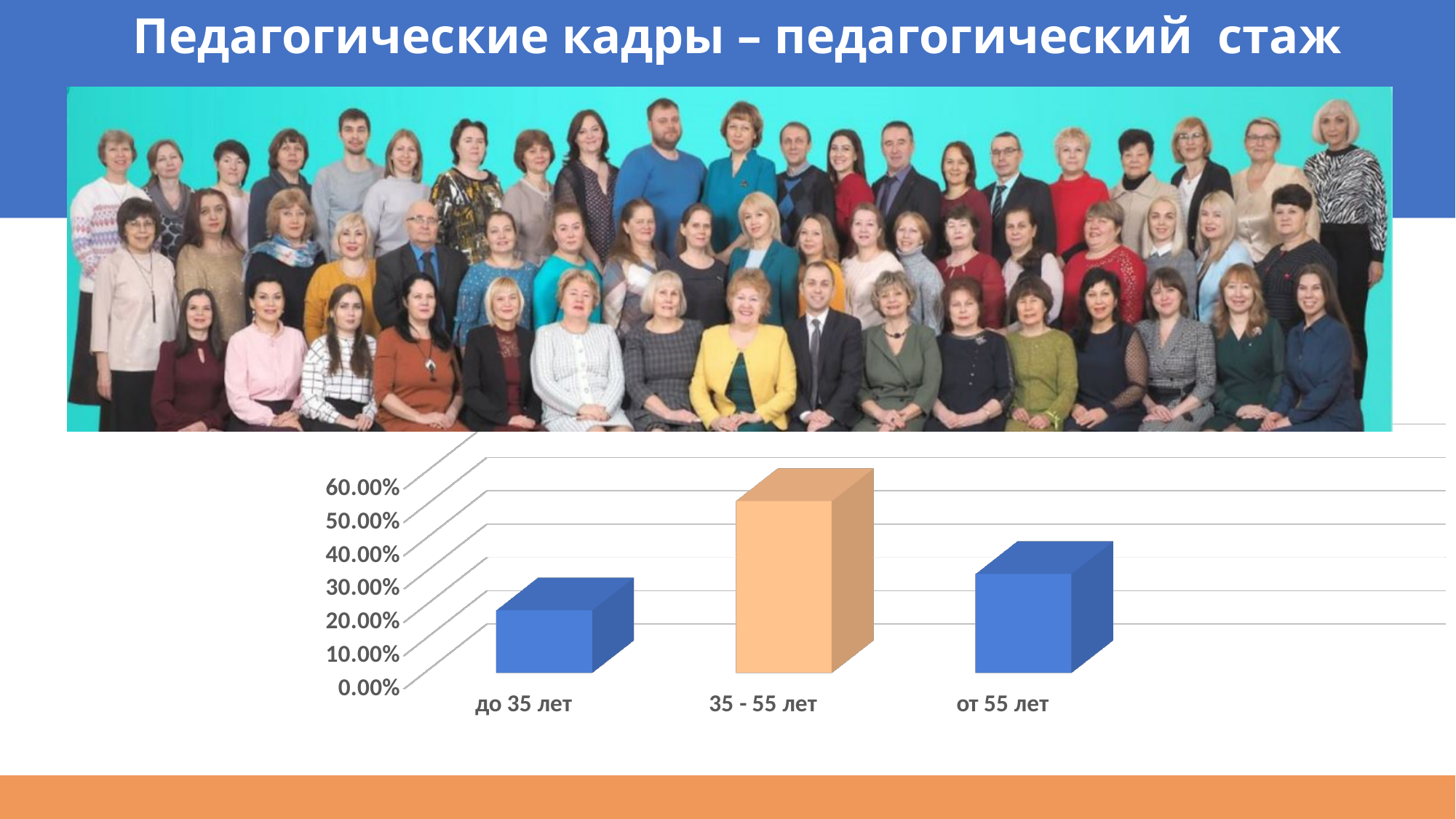
How many categories are shown on the x axis of the chart? 3 Which category has the highest bar in the chart? 35 - 55 лет Do the values rise or fall from 35 - 55 лет to от 55 лет? fall Which category has the lowest bar in the chart? до 35 лет Is the value for от 55 лет greater or less than 10.00%? greater Is the value for 35 - 55 лет greater or less than 40.00%? greater Is the value for до 35 лет greater or less than 30.00%? less What kind of chart is shown on the slide? bar chart Which is larger: the value for 35 - 55 лет or the value for от 55 лет? 35 - 55 лет What colour is the bar for 35 - 55 лет? orange Which is larger: the value for до 35 лет or the value for от 55 лет? от 55 лет